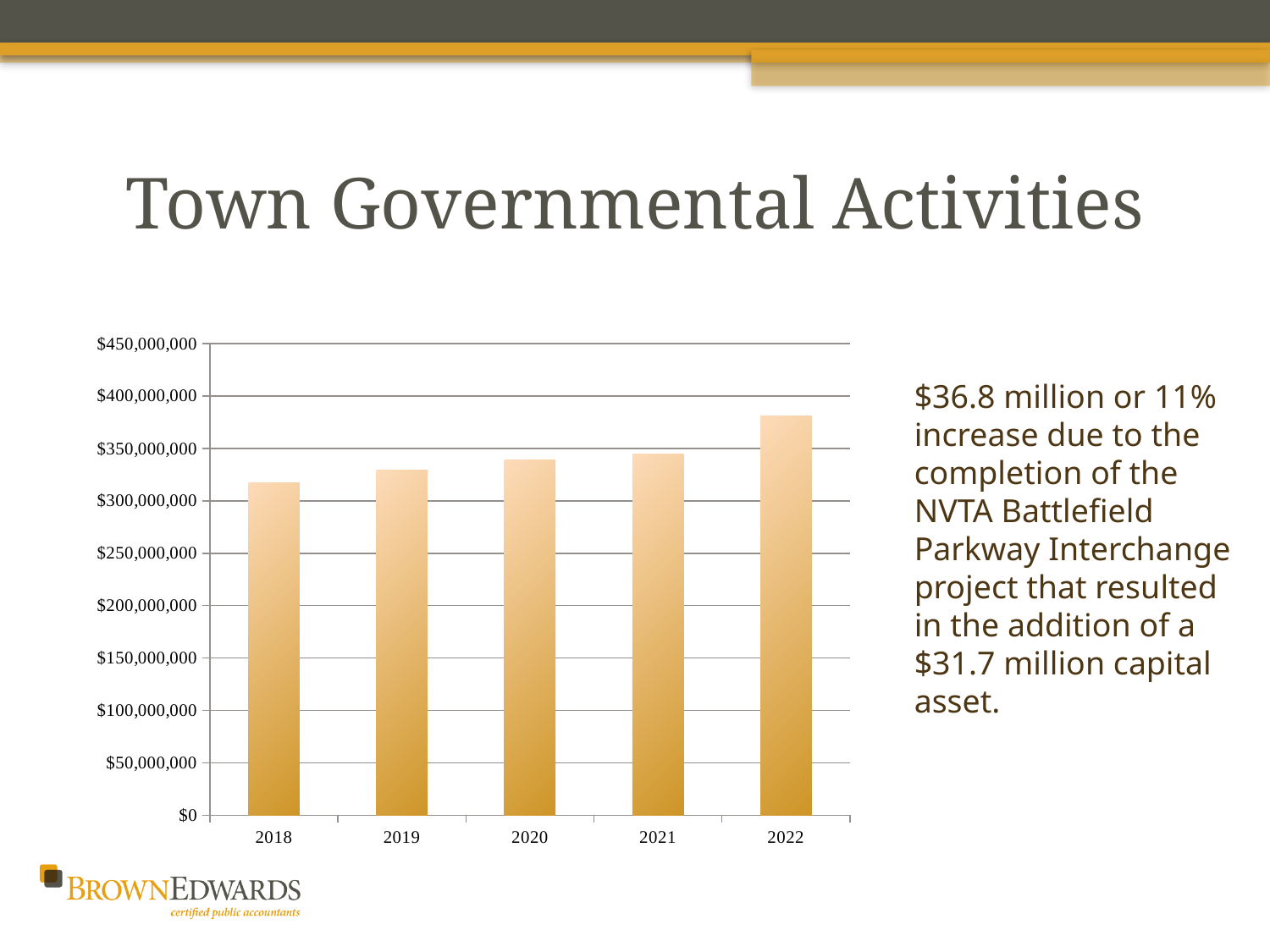
What kind of chart is shown on the slide? bar chart Do the values rise or fall from 2018 to 2022? rise Which year has the lowest value on the chart? 2018 Is the value for 2022 greater or less than $400,000,000? less Which is larger, the value for 2019 or the value for 2021? 2021 What is the title of the slide containing the chart? Town Governmental Activities Is the value for 2022 greater or less than $350,000,000? greater What is the first year shown on the x axis of the chart? 2018 Is the value for 2020 greater or less than $350,000,000? less Which year has the highest value on the chart? 2022 How many years are plotted on the chart? 5